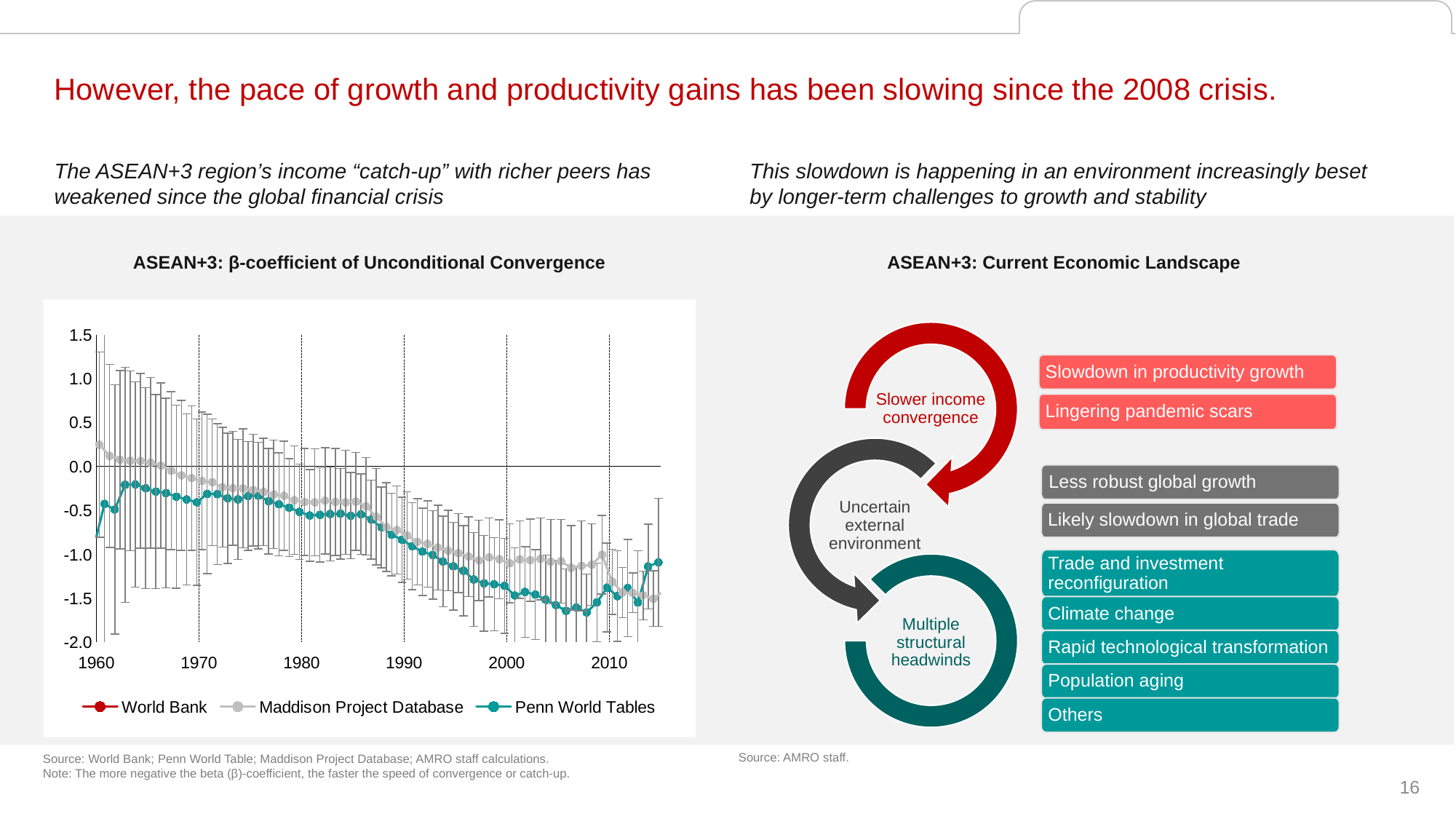
How many series does the legend of the β-coefficient chart list? 3 In the β-coefficient chart, which series has the higher value in 1960: Maddison Project Database or Penn World Tables? Maddison Project Database In the β-coefficient chart, is the Penn World Tables value in 2005 greater or less than -1.0? less How many year labels are shown on the x axis of the β-coefficient chart? 6 What kind of chart is the ASEAN+3: β-coefficient of Unconditional Convergence chart? Line chart In the β-coefficient chart, is the Maddison Project Database value in 1980 greater or less than 0.0? less In the β-coefficient chart, does the Maddison Project Database series generally rise or fall from 1960 to 2010? Fall In the β-coefficient chart, is the Maddison Project Database value in 1960 greater or less than 0.0? greater In the β-coefficient chart, which series has the higher value in 2000: Maddison Project Database or Penn World Tables? Maddison Project Database What is the title of the chart on the left of the slide? ASEAN+3: β-coefficient of Unconditional Convergence What are the three series named in the legend of the β-coefficient chart? World Bank, Maddison Project Database, Penn World Tables